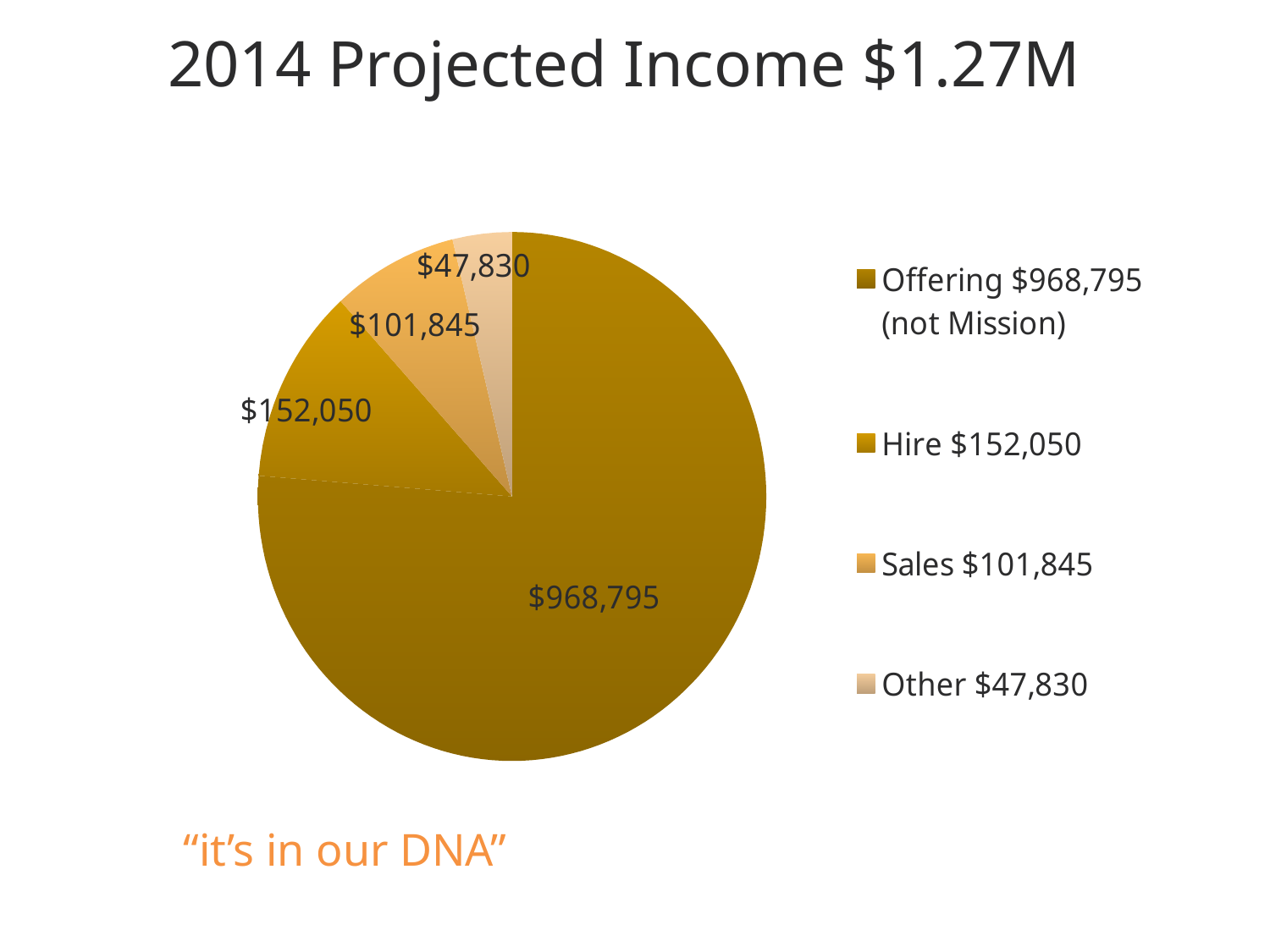
What kind of chart is shown on the slide? Pie chart Which category has the largest slice of the pie? Offering (not Mission) What is the projected income from Other? $47,830 How many categories does the pie chart show? 4 Which is larger, the Hire income or the Sales income? Hire What is the difference between the Sales income and the Other income? $54,015 What is the projected income from Offering (not Mission)? $968,795 What is the projected income from Hire? $152,050 Which category has the smallest slice of the pie? Other What is the difference between the Hire income and the Sales income? $50,205 What is the projected income from Sales? $101,845 What is the title of the chart on the slide? 2014 Projected Income $1.27M